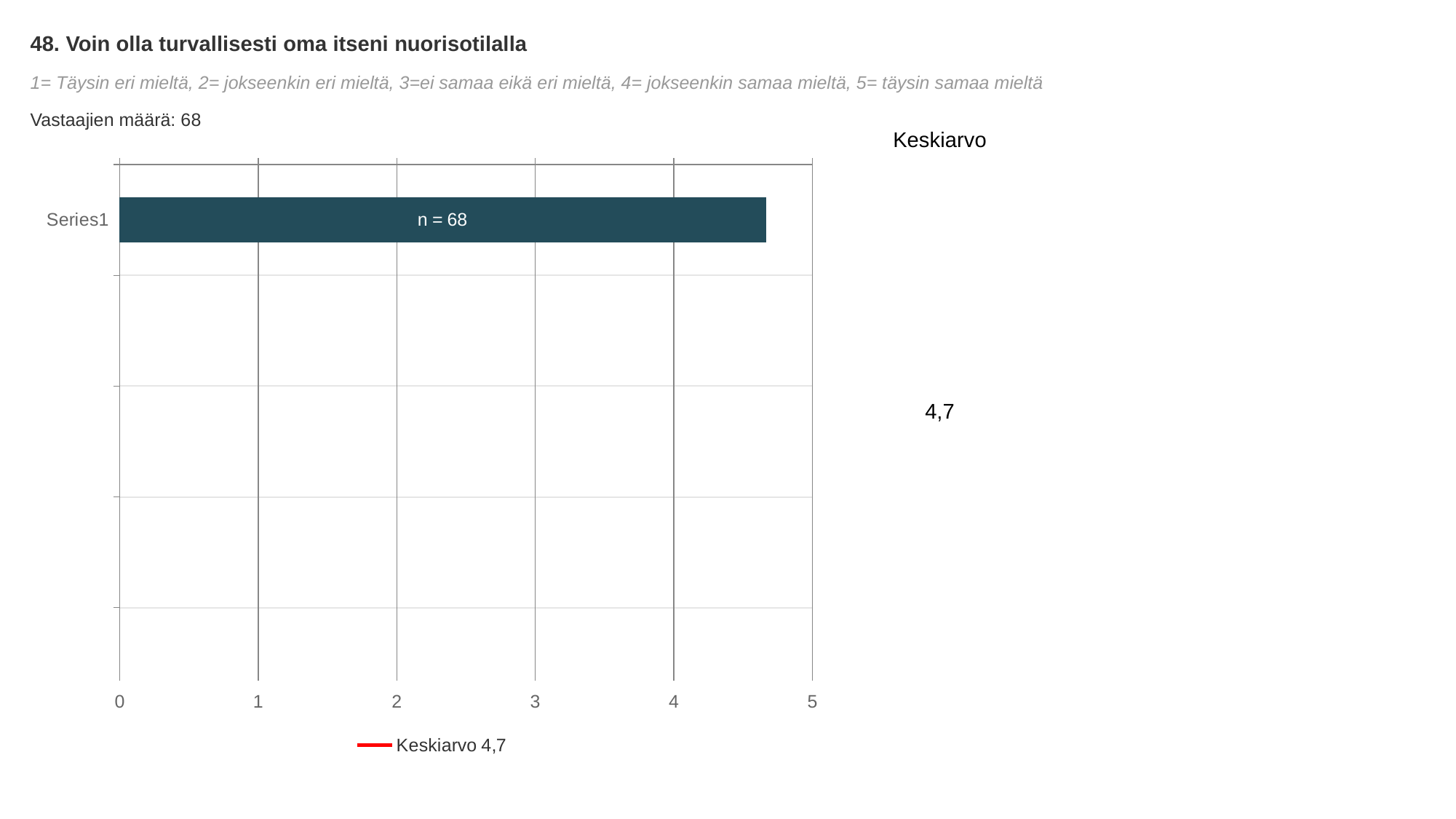
Is the value of the Series1 bar greater or less than 3? greater What is the Keskiarvo (mean) value shown on the slide? 4,7 What is the label of the category on the vertical axis? Series1 What text does the legend entry below the chart show? Keskiarvo 4,7 What data label is printed on the Series1 bar? n = 68 Is the value of the Series1 bar greater or less than 5? less What kind of chart is shown on the slide? bar chart Is the value of the Series1 bar greater or less than 4? greater How many respondents (Vastaajien määrä) are reported on the slide? 68 How many bars are plotted in the chart? 1 What is the highest value shown on the horizontal axis? 5